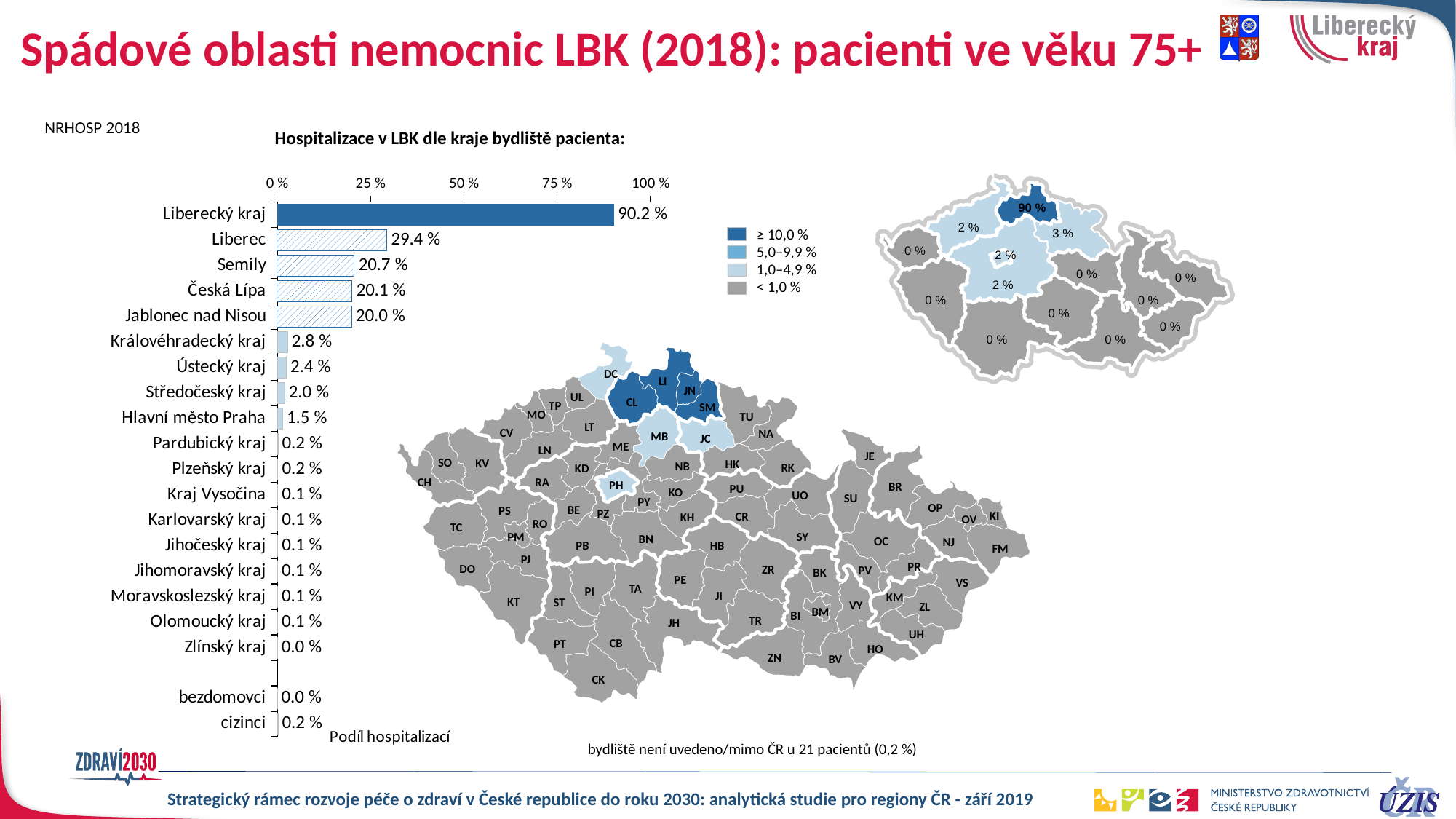
In the bar chart, which category has the highest value? Liberecký kraj In the bar chart, what is the difference between the values for Liberec and Semily? 8.7 % In the bar chart, what is the value for Hlavní město Praha? 1.5 % In the bar chart, which is larger: the value for Královéhradecký kraj or for Ústecký kraj? Královéhradecký kraj In the bar chart 'Hospitalizace v LBK dle kraje bydliště pacienta', what is the value for Liberecký kraj? 90.2 % In the bar chart, is the value for Liberecký kraj greater or less than 75 %? greater How many categories are shown in the bar chart? 20 What kind of chart is 'Hospitalizace v LBK dle kraje bydliště pacienta'? bar chart In the bar chart, what is the value for Jablonec nad Nisou? 20.0 % How many categories does the legend of the map list? 4 In the bar chart, what is the value for cizinci? 0.2 % In the bar chart, what is the value for Semily? 20.7 %